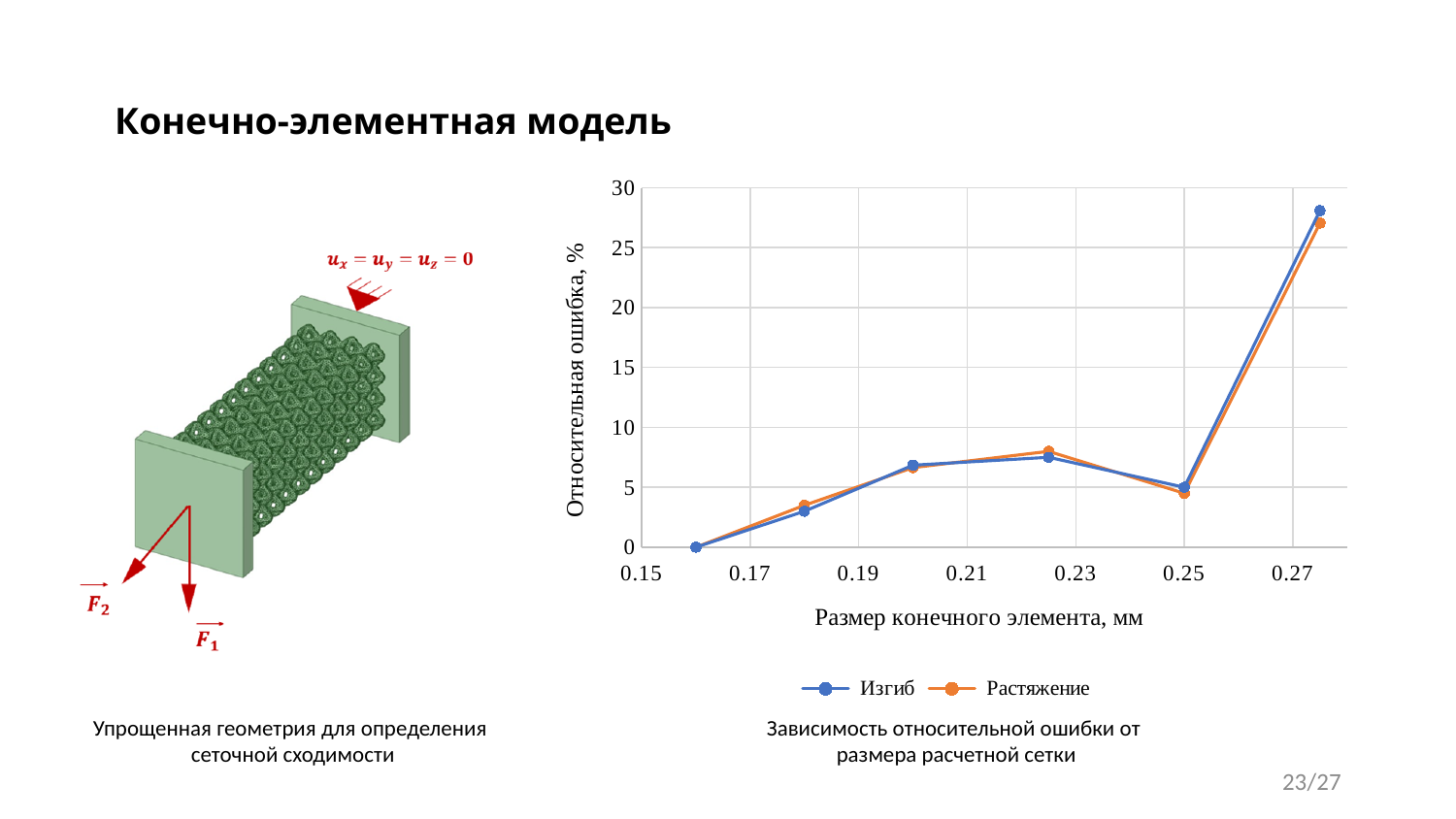
Between element sizes 0.25 mm and 0.27 mm, do the values of both series rise or fall? rise Is the value for Растяжение at element size 0.25 mm greater or less than 10? less Is the value for Изгиб at the leftmost point (smallest element size) greater or less than 5? less What is the label of the y axis? Относительная ошибка, % Does the relative error for Изгиб reach its highest value at the smallest or the largest element size? largest Is the value for Изгиб at the largest element size (rightmost point) greater or less than 25? greater How many data points does the Изгиб series have? 6 What are the names of the two series in the legend? Изгиб and Растяжение How many series does the chart legend list? 2 What kind of chart is shown on the slide? line chart